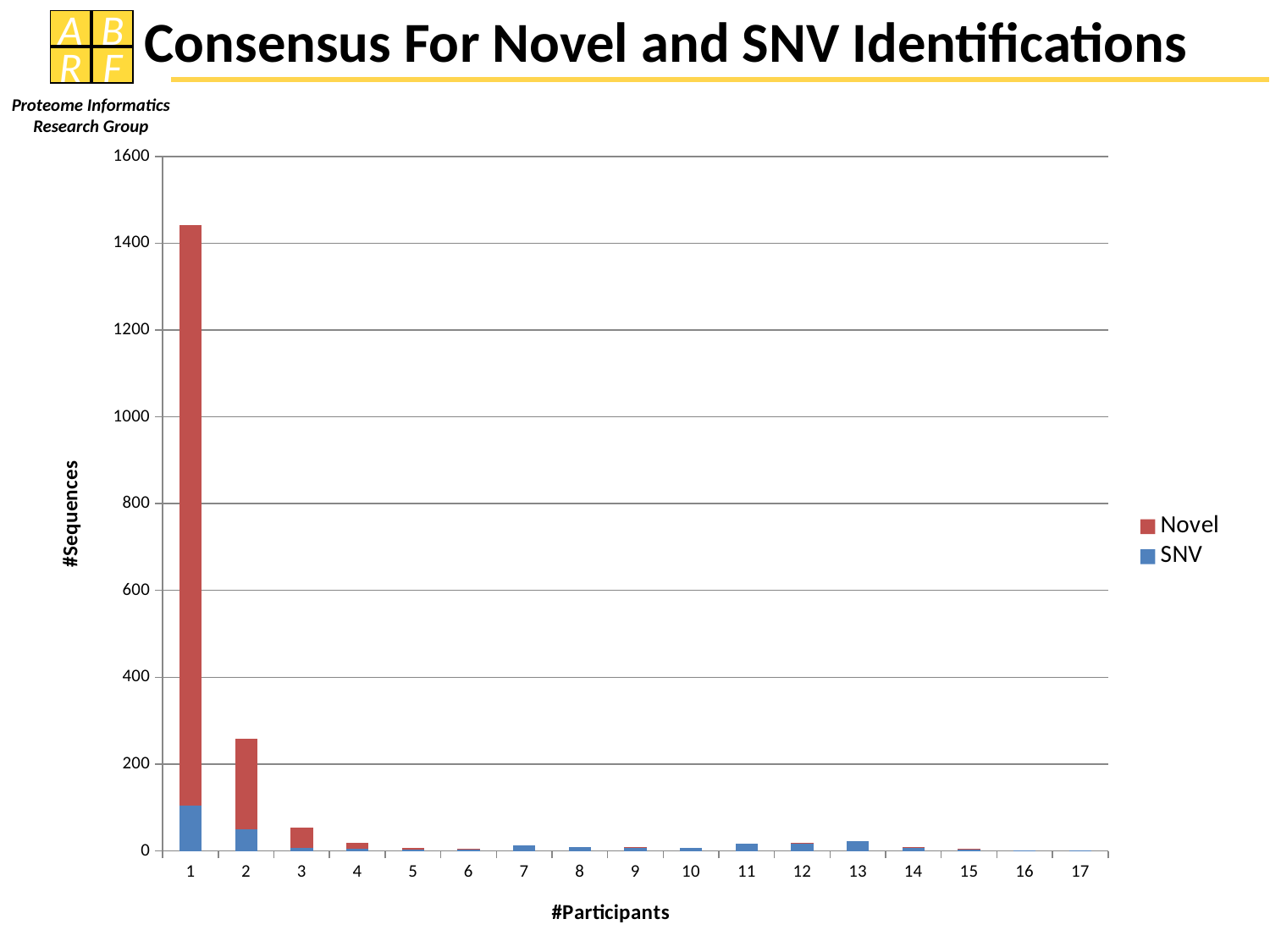
Which #Participants category has the highest total number of sequences? 1 Which series is shown in red in the legend? Novel Is the total value for #Participants = 13 greater or less than 200? less What kind of chart is shown on the slide? stacked bar chart How many categories are shown on the #Participants axis? 17 Which has a larger total number of sequences, #Participants = 1 or #Participants = 2? 1 Is the total value for #Participants = 1 greater or less than 1200? greater Do the total bar heights generally rise or fall as #Participants increases from 1 to 5? fall Is the total value for #Participants = 2 greater or less than 200? greater How many series does the legend list? 2 What is the label of the vertical axis? #Sequences